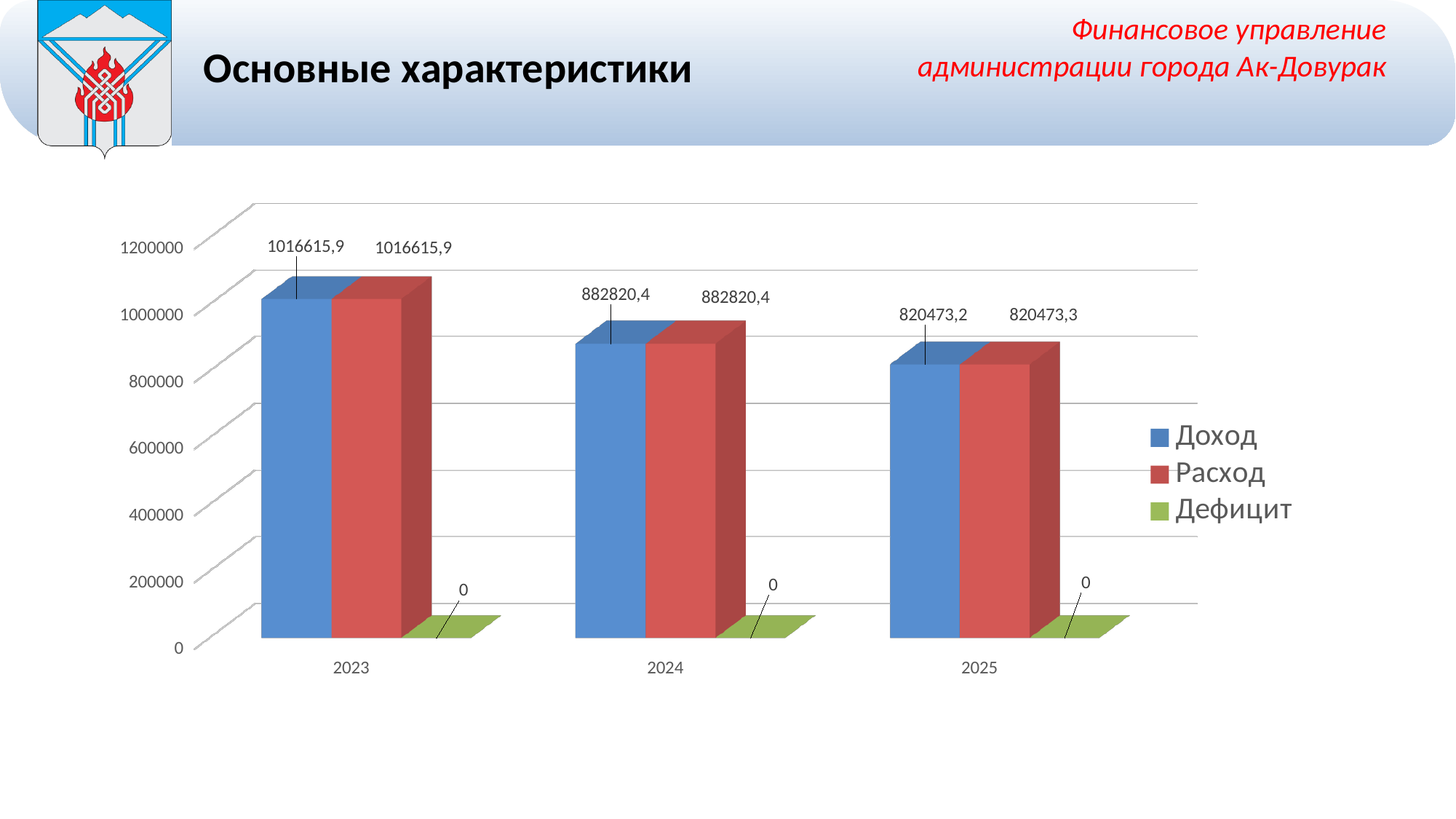
How many series does the legend list? 3 Is the value of Расход for 2023 greater or less than 1000000? greater What is the value of Дефицит for 2024? 0 What kind of chart is shown on the slide? Bar chart Which is larger: Доход in 2024 or Доход in 2025? Доход in 2024 How many years are shown on the x axis? 3 In which year is Расход the lowest? 2025 What is the value of Расход for 2024? 882820,4 What is the value of Расход for 2025? 820473,3 What is the difference between Доход in 2023 and Доход in 2024? 133795,5 What is the value of Доход for 2023? 1016615,9 In which year is Доход the highest? 2023